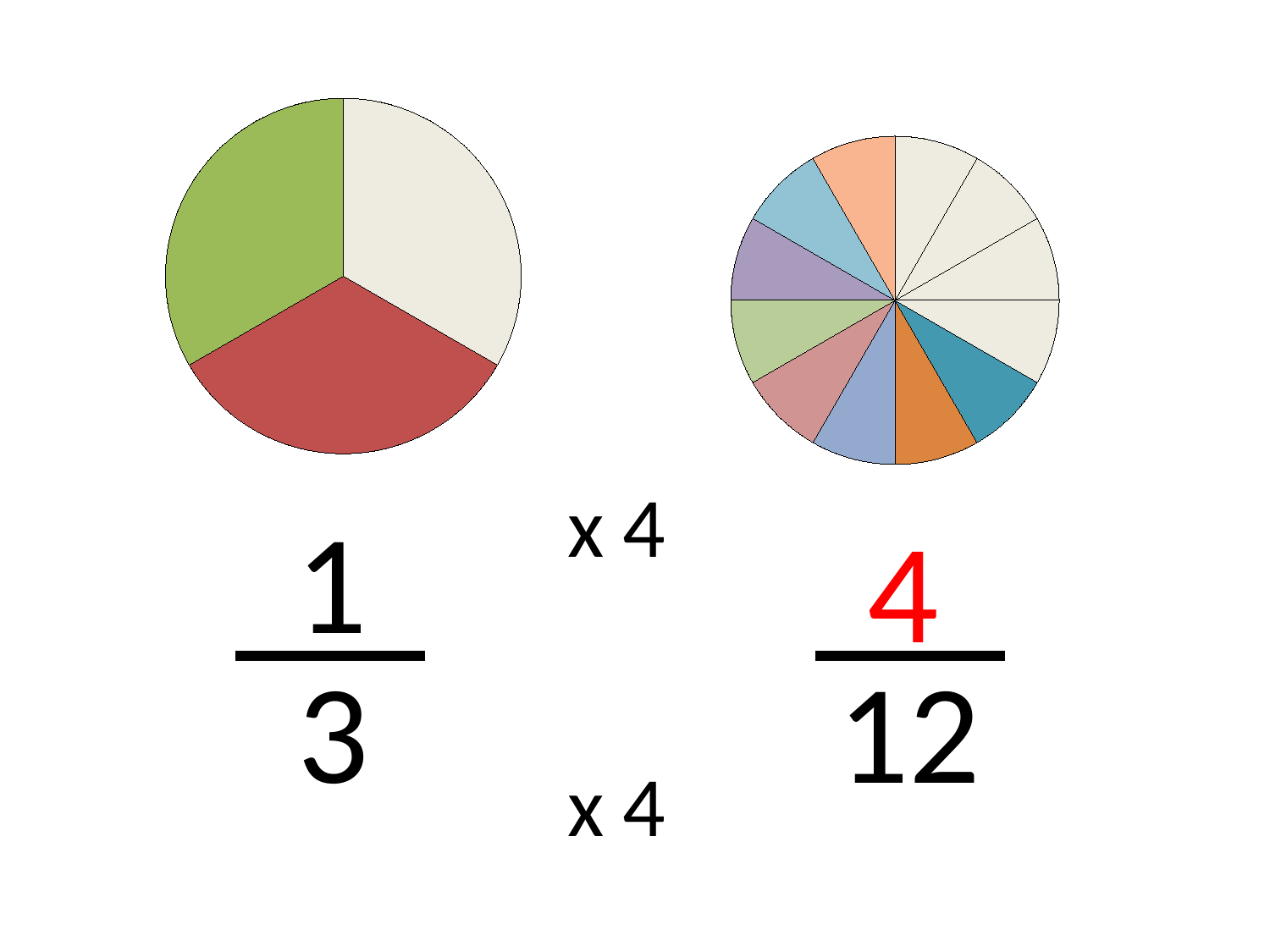
In the pie chart on the right, what share of the whole do the cream slices together represent? 4/12 What fraction is written below the pie chart on the left? 1/3 What fraction is written below the pie chart on the right? 4/12 In the pie chart on the left, what share of the whole does the green slice represent? 1/3 In the pie chart on the right, how many slices are coloured (not cream)? 8 How many slices does the pie chart on the right have? 12 How many slices does the pie chart on the left have? 3 Which chart has more slices, the pie chart on the left or the pie chart on the right? the pie chart on the right What kind of chart is the chart on the left of the slide? pie chart What kind of chart is the chart on the right of the slide? pie chart